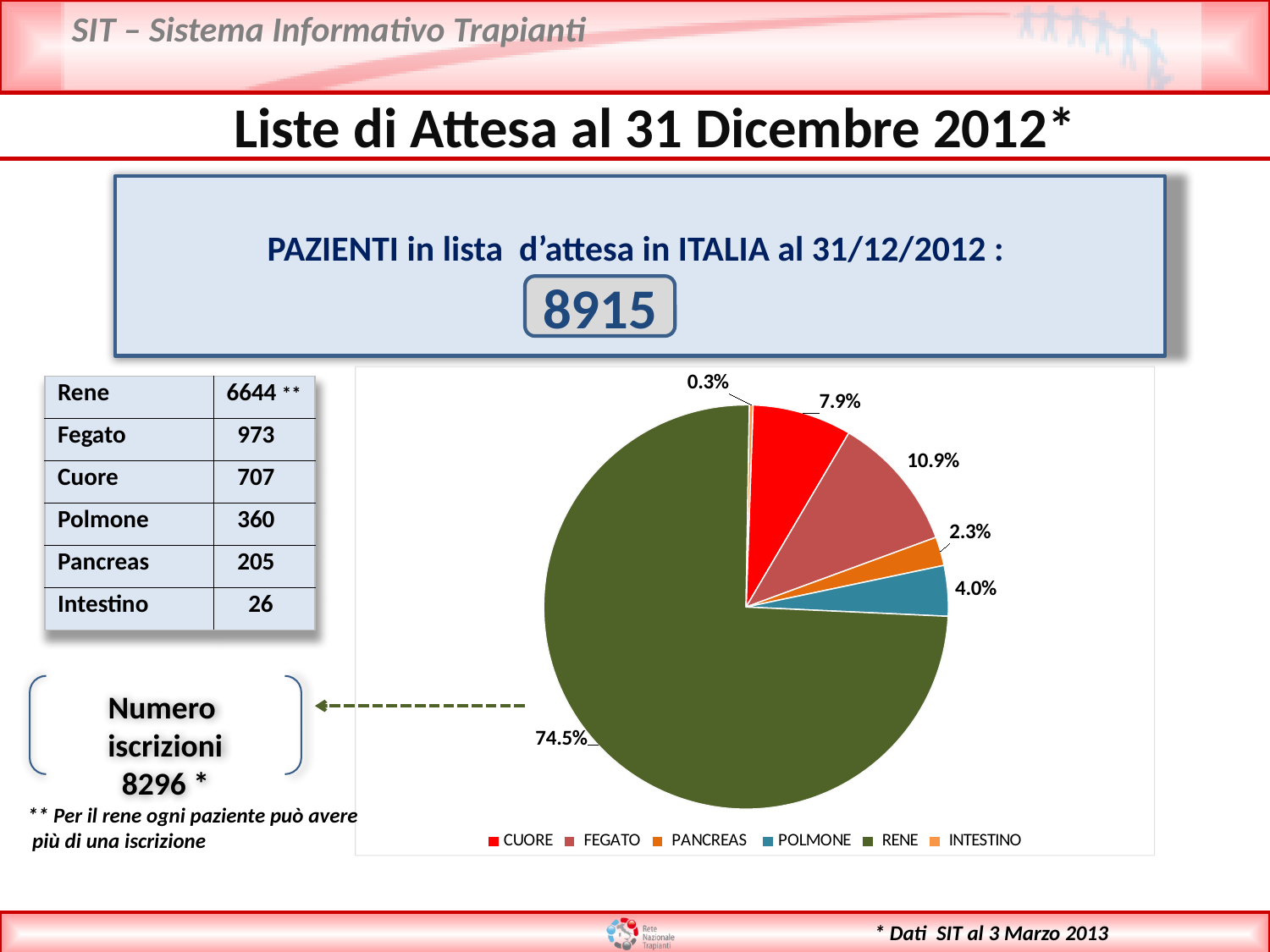
What percentage is shown for FEGATO in the pie chart? 10.9% Which category has the smallest slice in the pie chart? INTESTINO What percentage is shown for PANCREAS in the pie chart? 2.3% What percentage is shown for POLMONE in the pie chart? 4.0% What colour is the RENE slice in the pie chart? dark green What percentage is shown for CUORE in the pie chart? 7.9% What is the difference in percentage points between the FEGATO and CUORE slices? 3.0 What kind of chart is shown on the slide? pie chart What share of the pie chart does RENE represent? 74.5% Which is larger in the pie chart, the share for FEGATO or the share for CUORE? FEGATO Which category has the largest slice in the pie chart? RENE How many categories does the pie chart legend list? 6